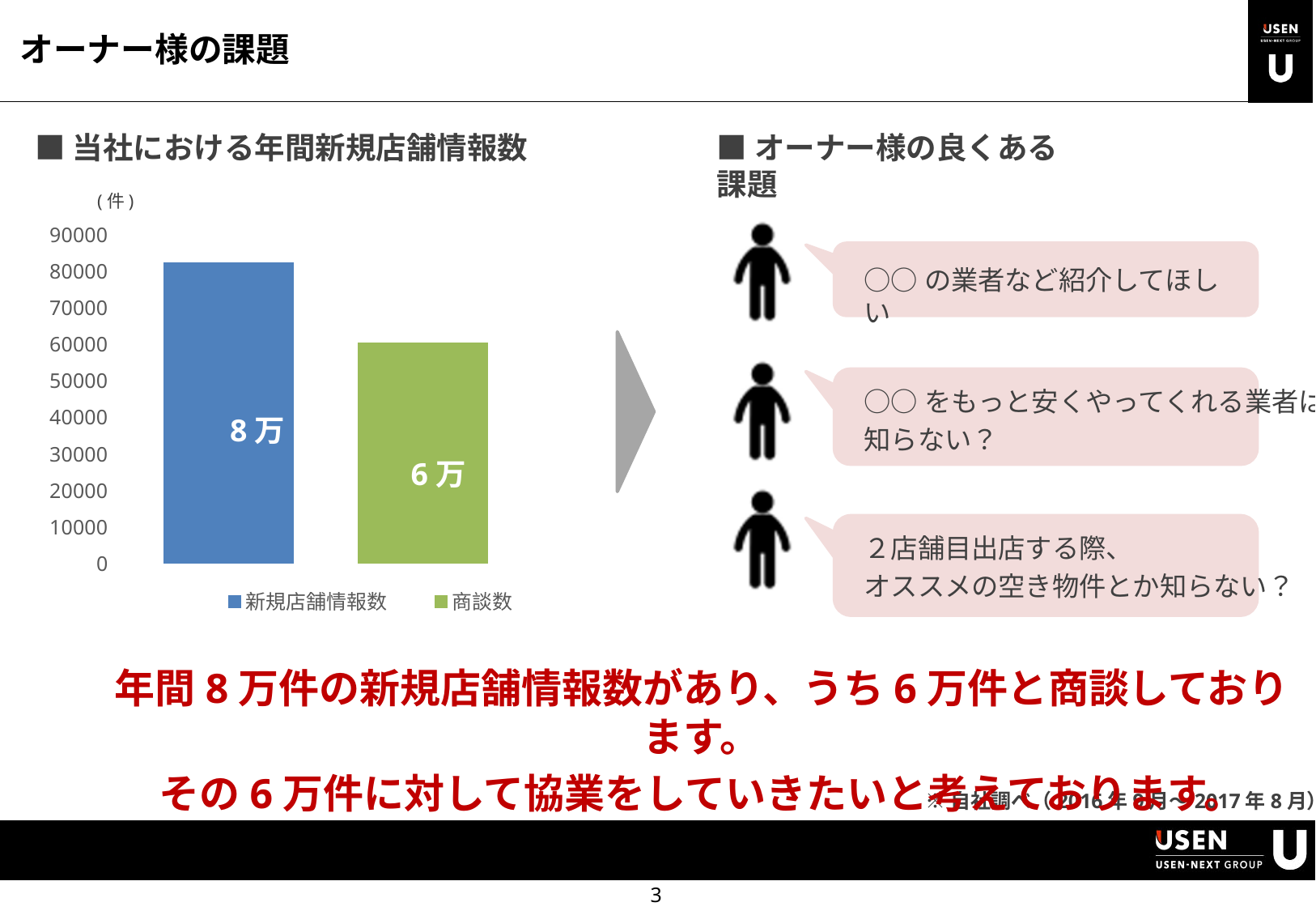
How many series does the legend list? 2 What unit is shown above the vertical axis of the chart? (件) Which bar is the highest in the chart? 新規店舗情報数 What value is labelled on the 新規店舗情報数 bar? 8万 Is the value for 商談数 greater or less than 70000? less Using the printed labels, what is the difference between 新規店舗情報数 and 商談数? 2万 What value is labelled on the 商談数 bar? 6万 Which series has the higher bar, 新規店舗情報数 or 商談数? 新規店舗情報数 How many bars are plotted in the chart? 2 Is the value for 新規店舗情報数 greater or less than 70000? greater Which bar is the lowest in the chart? 商談数 What kind of chart is shown under 当社における年間新規店舗情報数? bar chart